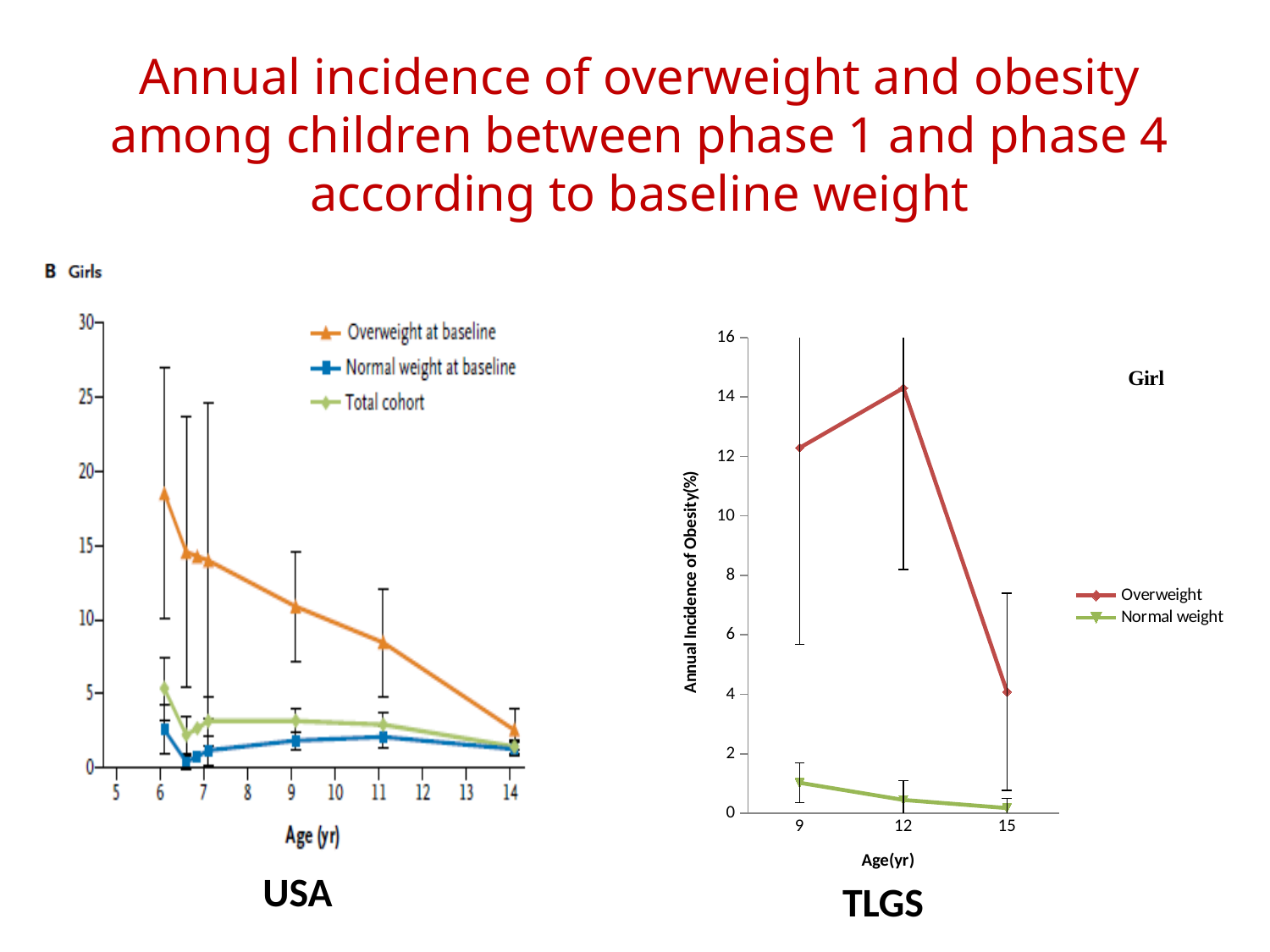
In the USA chart, which series has the highest value at age 9? Overweight at baseline What kind of chart is the TLGS chart on the right of the slide? line chart How many series does the legend of the TLGS chart list? 2 In the TLGS chart, is the Overweight value at age 15 greater or less than 6? less In the TLGS chart, is the Overweight value at age 9 greater or less than 10? greater In the TLGS chart, is the Normal weight value at age 9 greater or less than 2? less In the USA chart, does the Overweight at baseline series rise or fall from age 6 to age 14? fall How many age points are plotted on the x axis of the TLGS chart? 3 In the TLGS chart, which series has the larger value at age 12, Overweight or Normal weight? Overweight In the TLGS chart, at which age is the Overweight series highest? 12 How many series does the legend of the USA chart on the left list? 3